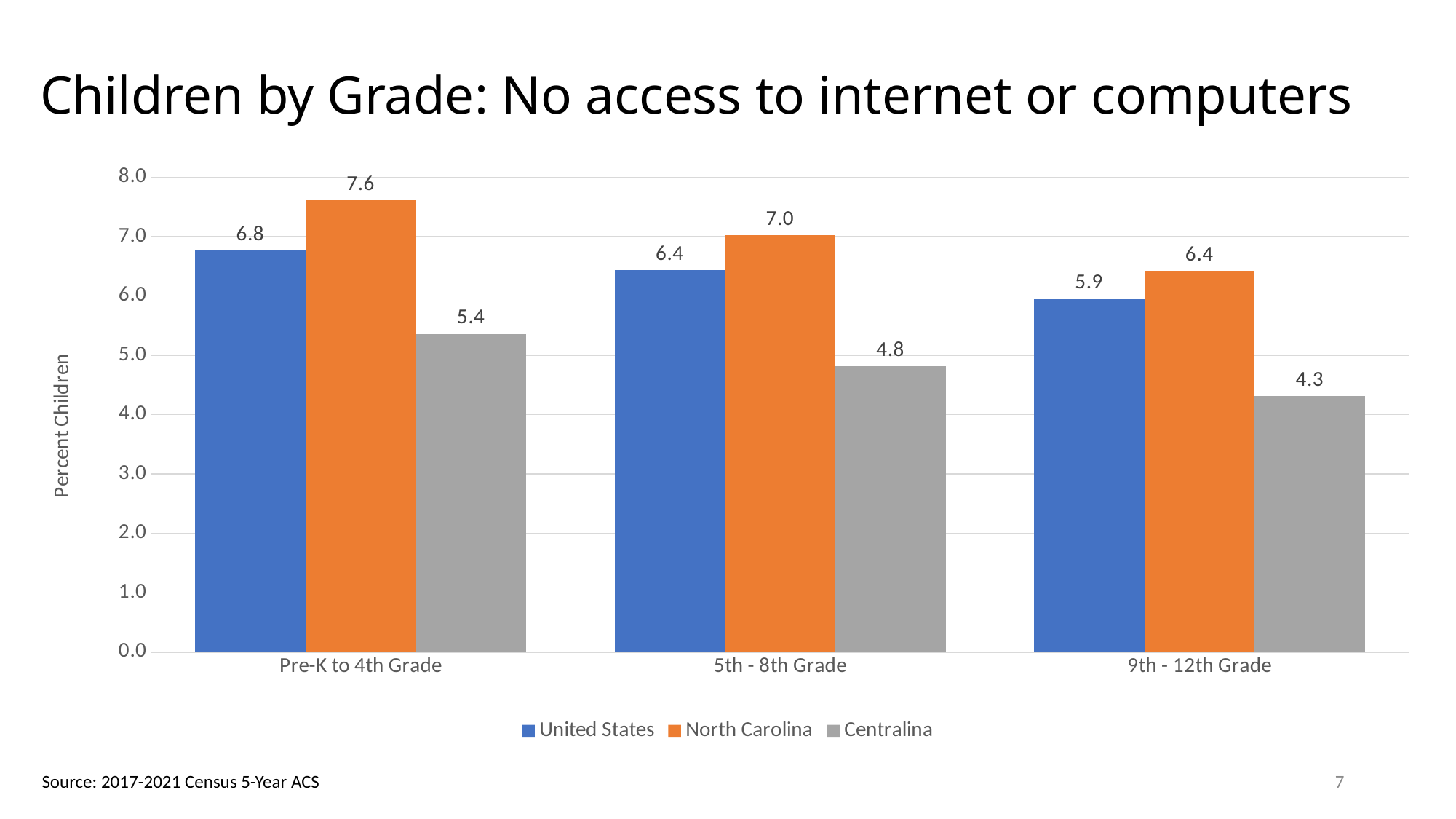
What kind of chart is shown on the slide? bar chart Do the United States values rise or fall from Pre-K to 4th Grade to 9th - 12th Grade? fall Which grade category has the lowest value for Centralina? 9th - 12th Grade How many series does the legend list? 3 What is the difference between the North Carolina and Centralina values in the 5th - 8th Grade category? 2.2 What is the value for United States in the 5th - 8th Grade category? 6.4 Is the value for Centralina in the Pre-K to 4th Grade category greater or less than 6.0? less Which grade category has the highest value for North Carolina? Pre-K to 4th Grade Which is larger in the 9th - 12th Grade category, United States or North Carolina? North Carolina What is the value for North Carolina in the Pre-K to 4th Grade category? 7.6 How many grade categories are shown on the x axis? 3 What is the value for Centralina in the 9th - 12th Grade category? 4.3